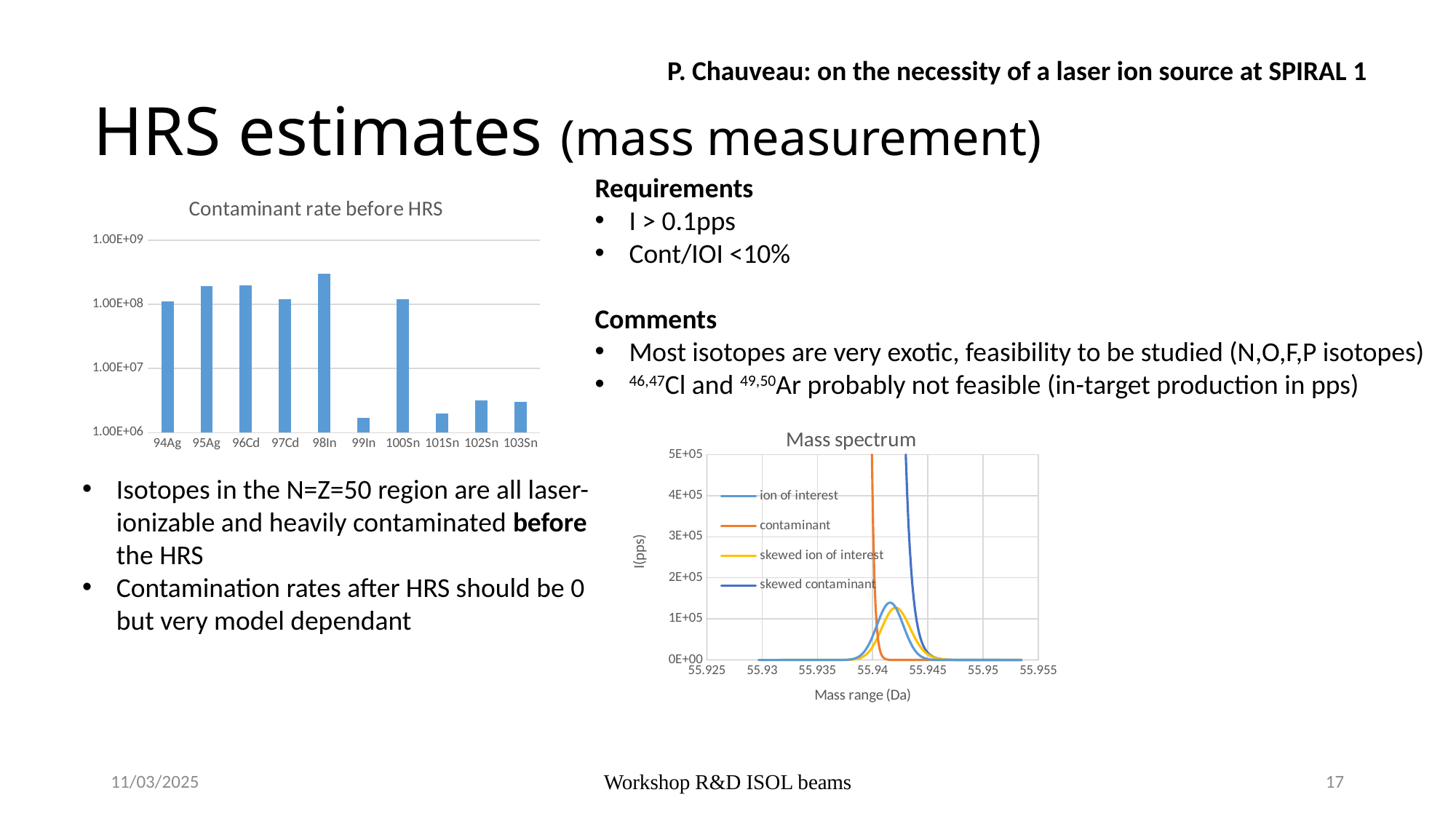
In the 'Contaminant rate before HRS' chart, is the value for 98In greater or less than 1.00E+08? greater What type of chart is the 'Mass spectrum' chart? line chart In the 'Contaminant rate before HRS' chart, is the value for 99In greater or less than 1.00E+07? less In the 'Contaminant rate before HRS' chart, which isotope has the highest contaminant rate? 98In What is the x-axis label of the 'Mass spectrum' chart? Mass range (Da) In the 'Contaminant rate before HRS' chart, is the value for 94Ag greater or less than 1.00E+07? greater In the 'Contaminant rate before HRS' chart, which has the larger contaminant rate, 100Sn or 101Sn? 100Sn In the 'Contaminant rate before HRS' chart, which has the larger contaminant rate, 95Ag or 103Sn? 95Ag How many isotopes are shown on the x axis of the 'Contaminant rate before HRS' chart? 10 What type of chart is the 'Contaminant rate before HRS' chart? bar chart How many series does the legend of the 'Mass spectrum' chart list? 4